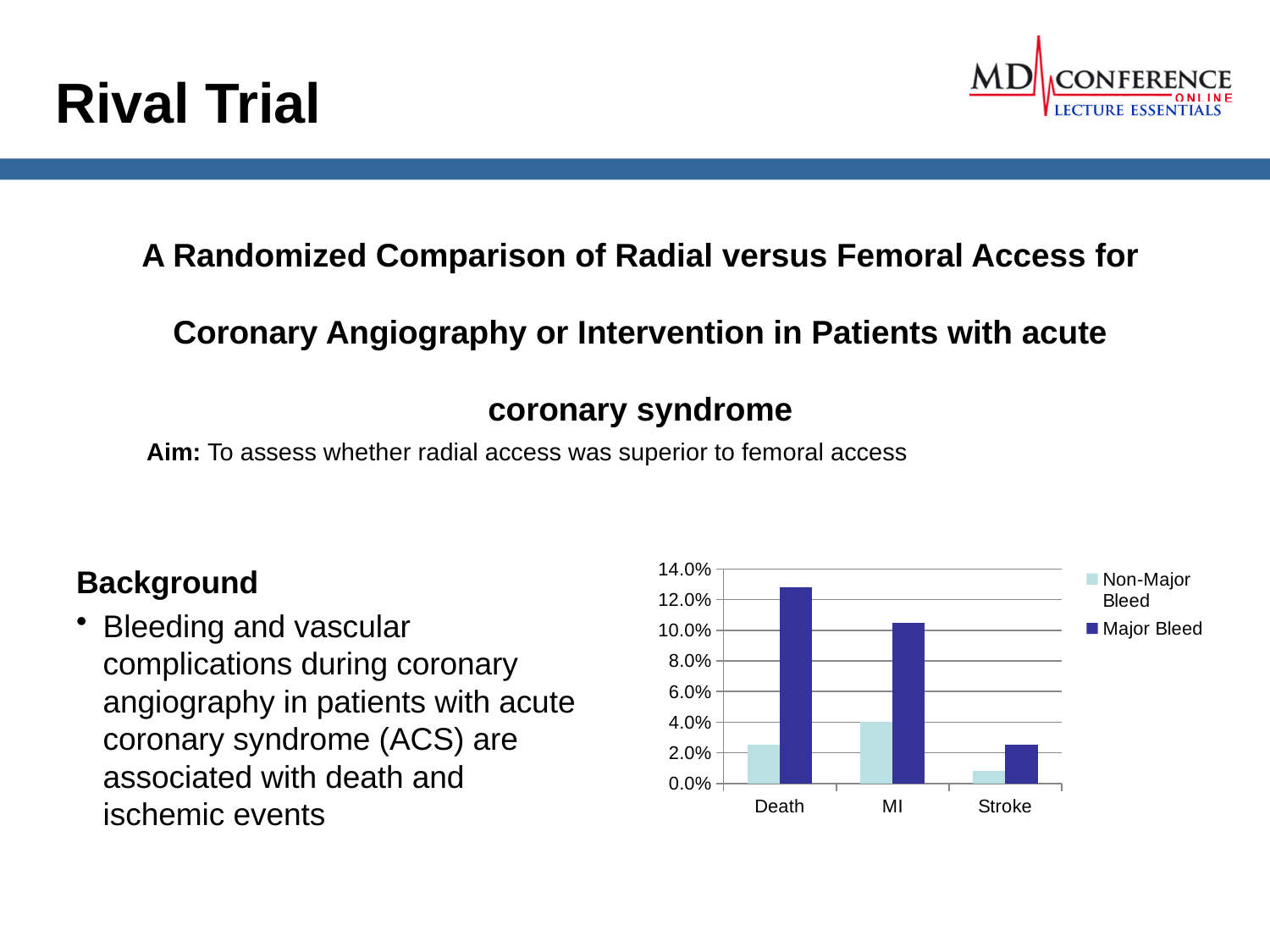
Which is larger, the Major Bleed value for Death or the Major Bleed value for MI? Death Which category has the lowest Non-Major Bleed value? Stroke Which category has the lowest Major Bleed value? Stroke Is the Non-Major Bleed value for Death greater or less than 4.0%? less How many series does the chart legend list? 2 Do the Major Bleed values rise or fall from Death to Stroke along the x axis? fall What kind of chart is shown on the slide? bar chart Is the Major Bleed value for Stroke greater or less than 4.0%? less Which category has the highest Non-Major Bleed value? MI How many categories are shown on the x axis of the chart? 3 Is the Major Bleed value for Death greater or less than 12.0%? greater Which category has the highest Major Bleed value? Death